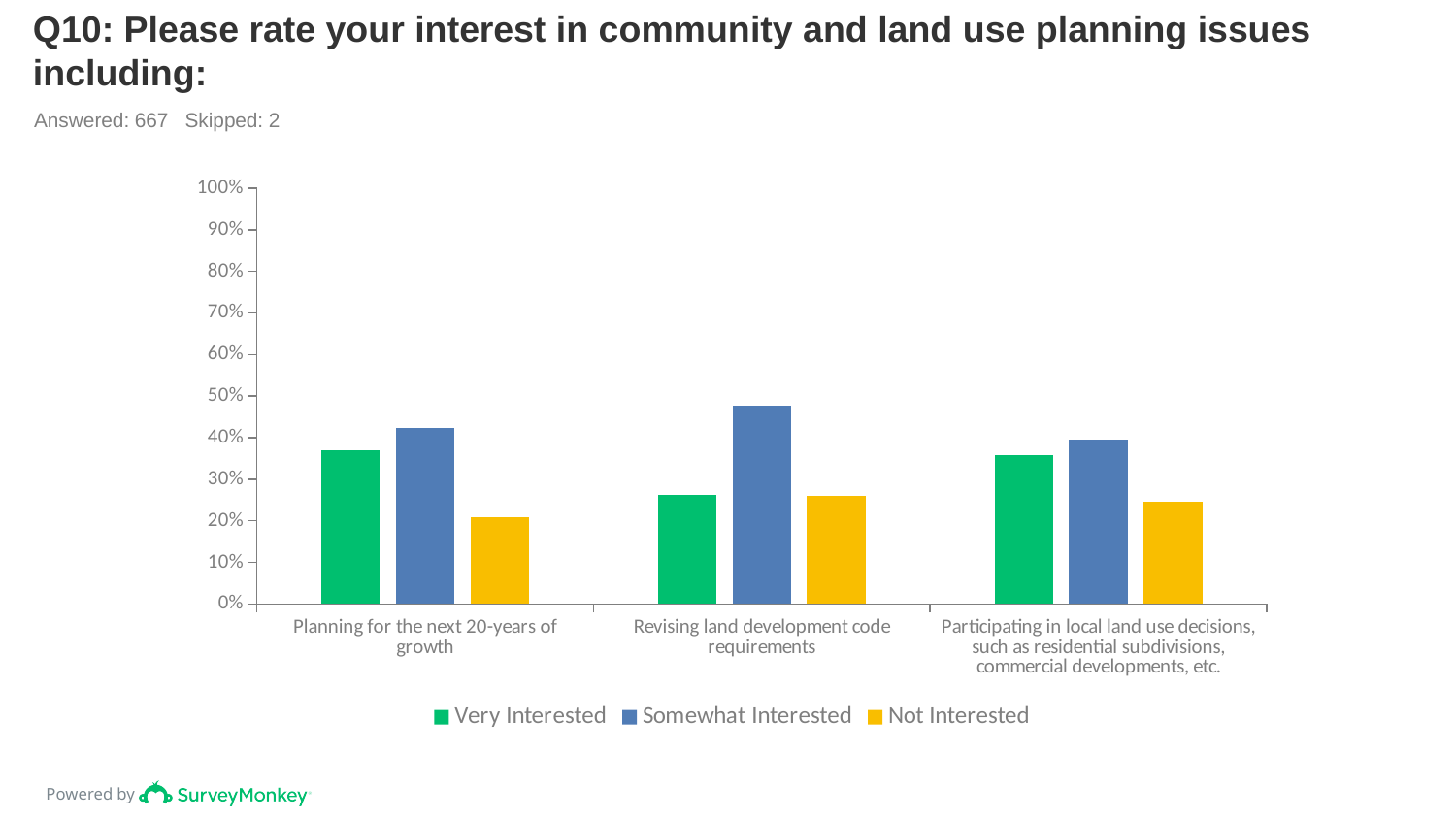
Which category has the highest Somewhat Interested value? Revising land development code requirements Is the Very Interested value for "Revising land development code requirements" greater or less than 30%? less How many categories are shown along the x axis? 3 How many series does the legend list? 3 Is the Very Interested value larger for "Planning for the next 20-years of growth" or for "Revising land development code requirements"? Planning for the next 20-years of growth Is the Somewhat Interested value for "Revising land development code requirements" greater or less than 40%? greater What kind of chart is shown on the slide? bar chart Is the Not Interested value for "Planning for the next 20-years of growth" greater or less than 30%? less Which colour represents the Not Interested series in the legend? yellow Which category has the lowest Not Interested value? Planning for the next 20-years of growth Which series has the tallest bar for "Revising land development code requirements"? Somewhat Interested